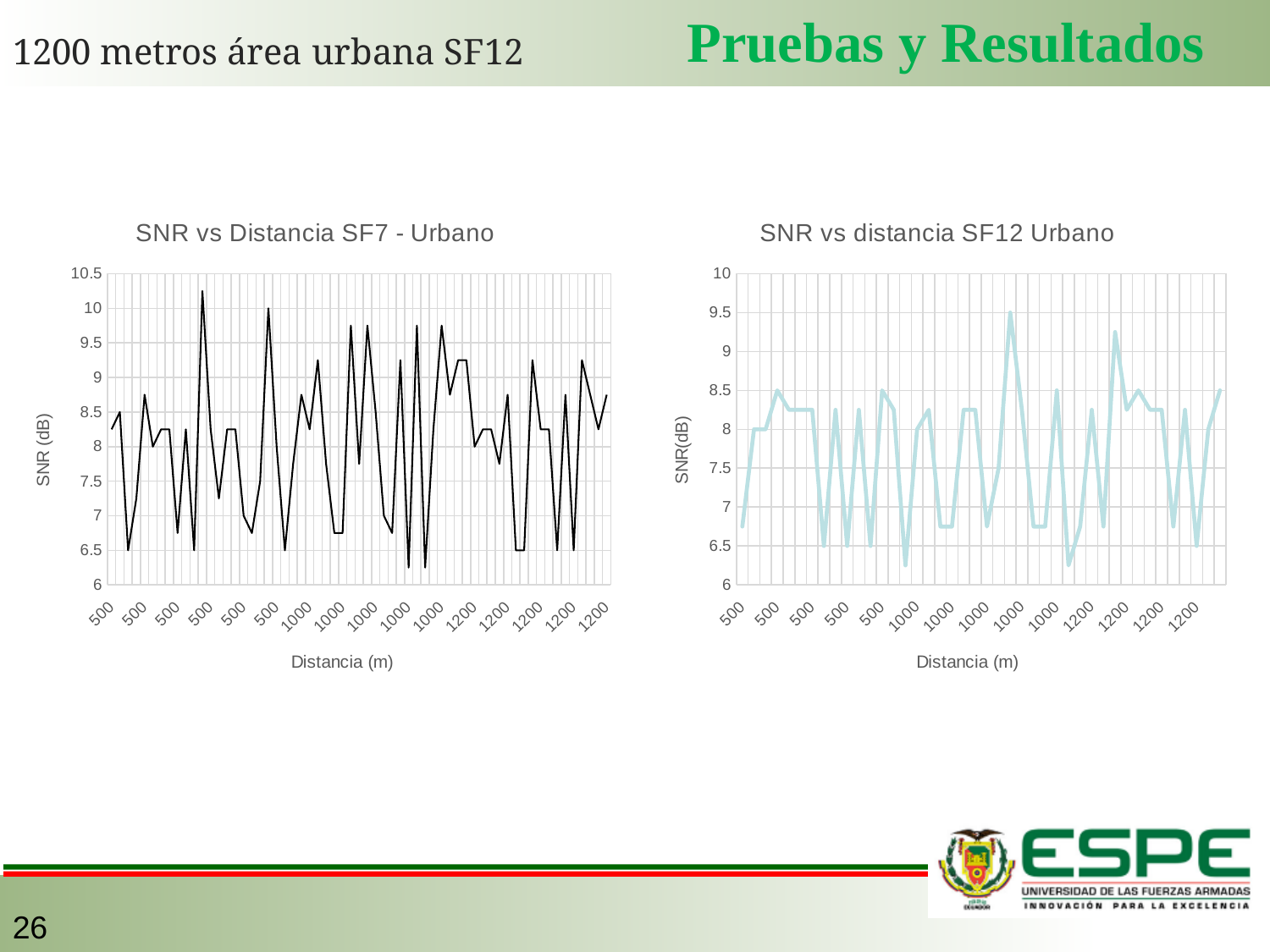
What kind of chart is 'SNR vs distancia SF12 Urbano'? line chart What is the y-axis label of the 'SNR vs Distancia SF7 - Urbano' chart? SNR (dB) How many distinct distance values appear on the x axis of the 'SNR vs distancia SF12 Urbano' chart? 3 In the 'SNR vs distancia SF12 Urbano' chart, is the lowest SNR value greater or less than 6.5? less In the 'SNR vs distancia SF12 Urbano' chart, is the highest SNR value greater or less than 9? greater In the 'SNR vs Distancia SF7 - Urbano' chart, is the highest SNR value greater or less than 10? greater What kind of chart is 'SNR vs Distancia SF7 - Urbano'? line chart What is the x-axis label of the 'SNR vs distancia SF12 Urbano' chart? Distancia (m)